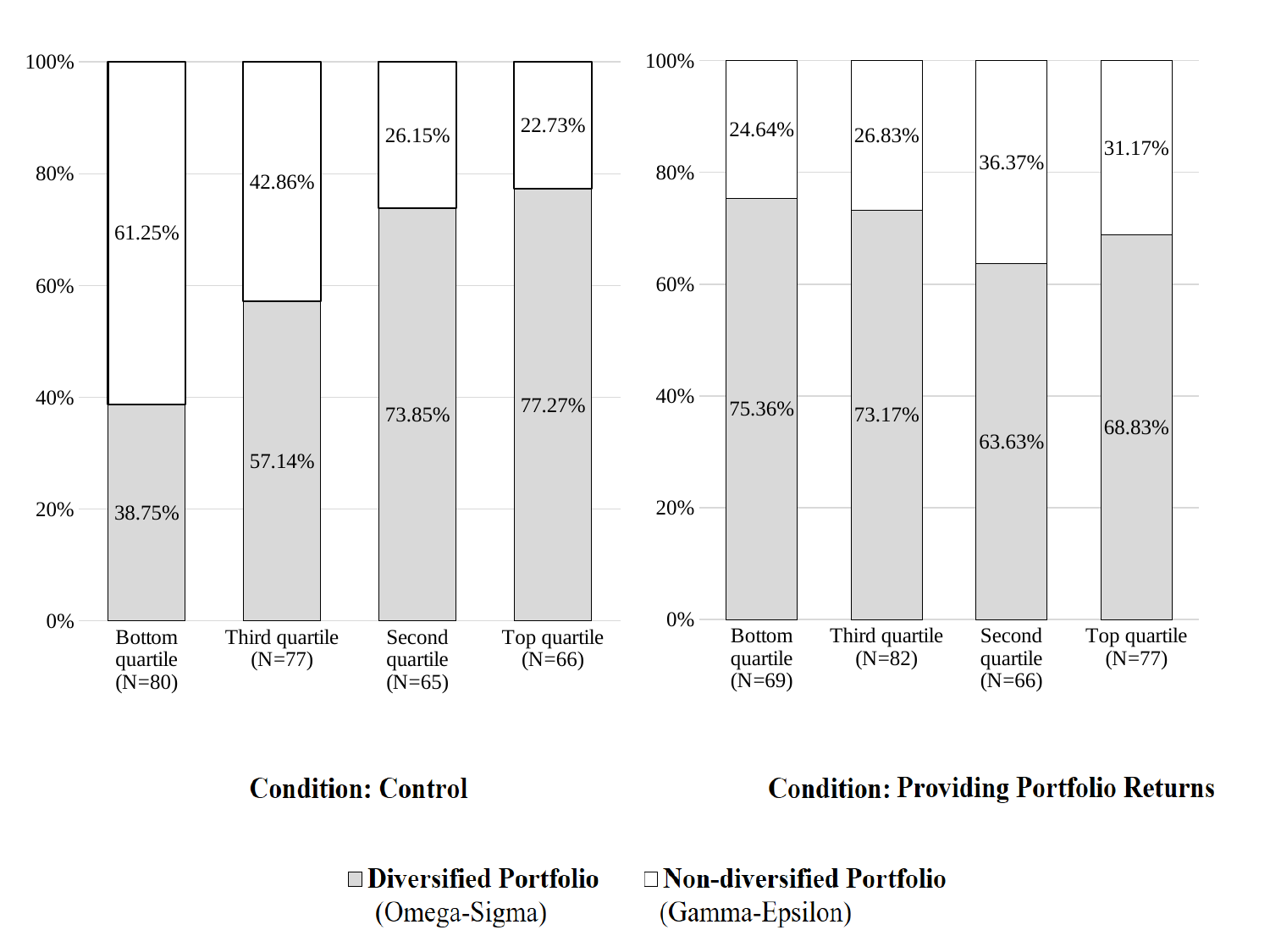
What type of chart is used for the Condition: Control condition? Stacked bar chart In the Condition: Control chart, what is the difference between the Diversified Portfolio shares of the Top quartile and the Bottom quartile? 38.52% How many series does the legend list? 2 How many quartile categories are shown in the Condition: Providing Portfolio Returns chart? 4 In the Condition: Control chart, does the Diversified Portfolio share rise or fall from the Bottom quartile to the Top quartile? Rise In the Condition: Control chart, what is the Non-diversified Portfolio share for the Third quartile? 42.86% In the Condition: Providing Portfolio Returns chart, what is the Non-diversified Portfolio share for the Top quartile? 31.17% Which is larger: the Diversified Portfolio share for the Bottom quartile in the Control chart or in the Providing Portfolio Returns chart? Providing Portfolio Returns In the Condition: Providing Portfolio Returns chart, which quartile has the lowest Diversified Portfolio share? Second quartile In the Condition: Control chart, which quartile has the highest Diversified Portfolio share? Top quartile In the Condition: Control chart, what is the Diversified Portfolio share for the Bottom quartile? 38.75% In the Condition: Providing Portfolio Returns chart, what is the Diversified Portfolio share for the Second quartile? 63.63%